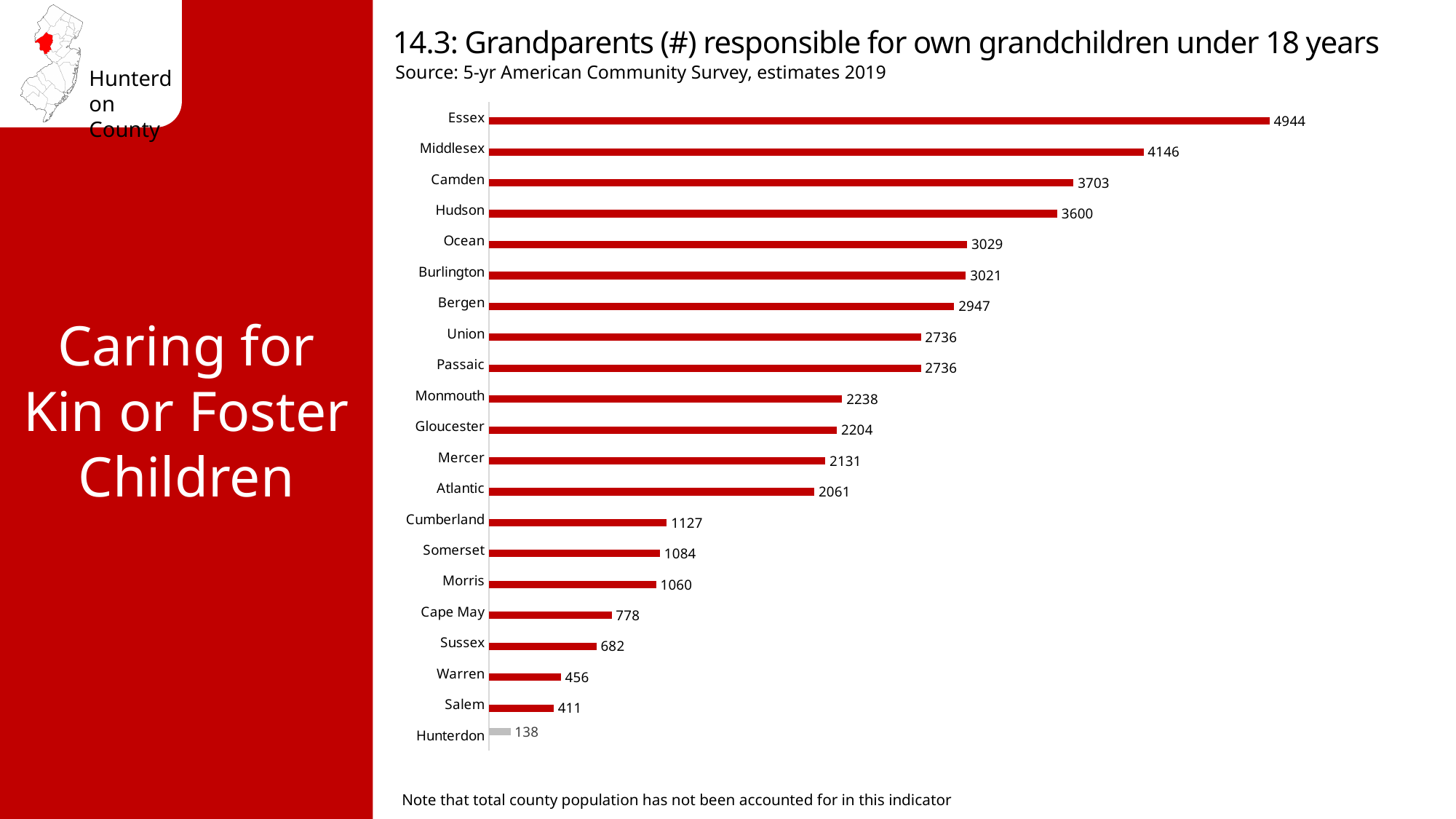
What kind of chart is shown on the slide? Bar chart What is the value for Hunterdon? 138 Which county's bar is shown in grey rather than red? Hunterdon Which county has the lowest value? Hunterdon What is the difference between the values for Salem and Hunterdon? 273 Which county has the highest value? Essex How many counties are shown in the chart? 21 What is the difference between the values for Essex and Middlesex? 798 What is the source cited under the chart title? 5-yr American Community Survey, estimates 2019 What is the value for Cape May? 778 Which is larger, the value for Camden or the value for Ocean? Camden What is the value for Essex? 4944